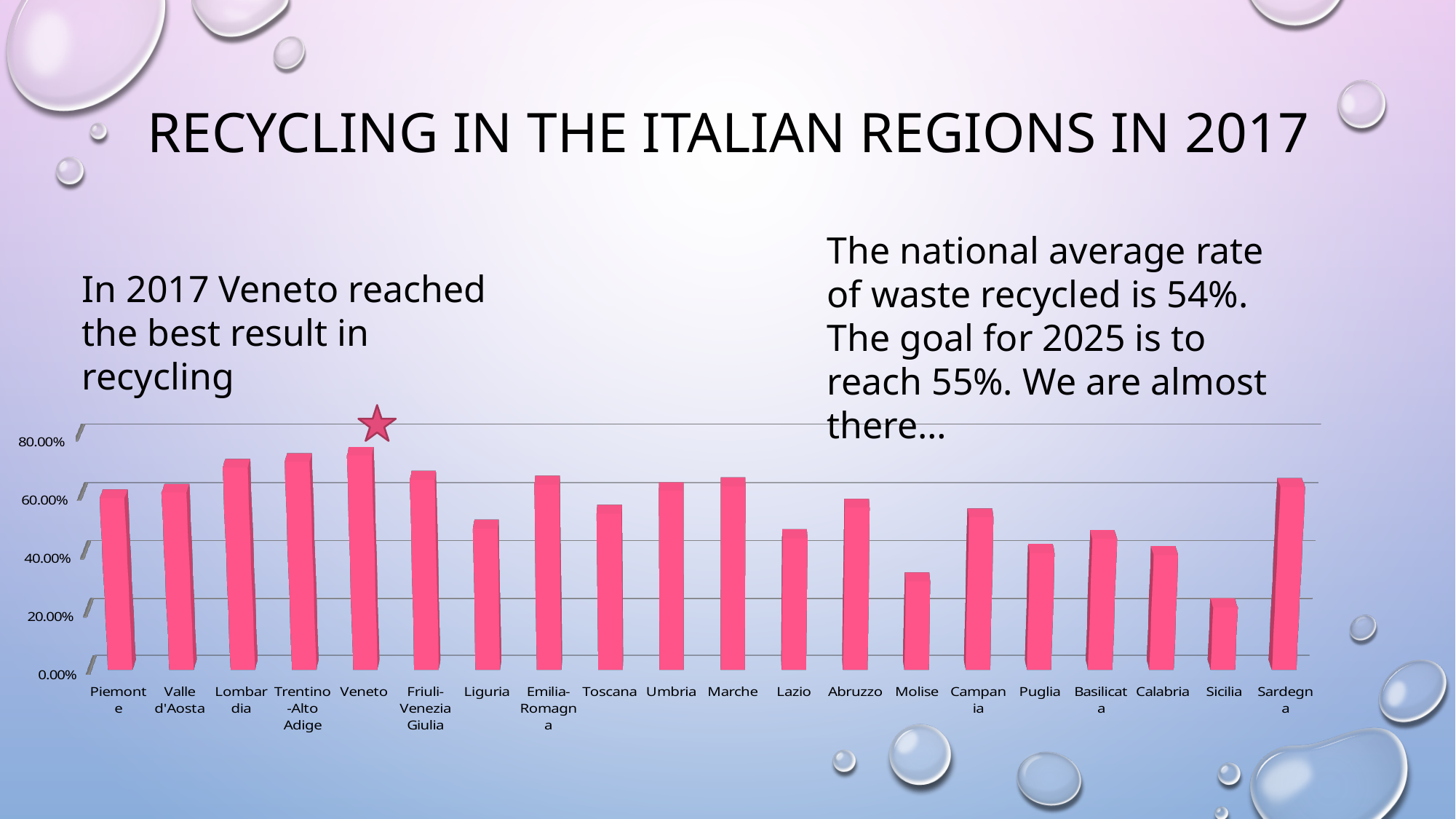
Is the value for Sicilia greater or less than 40.00%? less Which region has the highest recycling rate in the chart? Veneto What kind of chart is shown on the slide? bar chart Which has the higher recycling rate, Molise or Sardegna? Sardegna Is the value for Molise greater or less than 40.00%? less Which has the higher recycling rate, Lombardia or Liguria? Lombardia What is the title of the slide containing the chart? Recycling in the Italian regions in 2017 Is the value for Liguria greater or less than 60.00%? less Which region has the lowest recycling rate in the chart? Sicilia Which region's bar is marked with a star above it? Veneto How many regions are shown on the x axis of the chart? 20